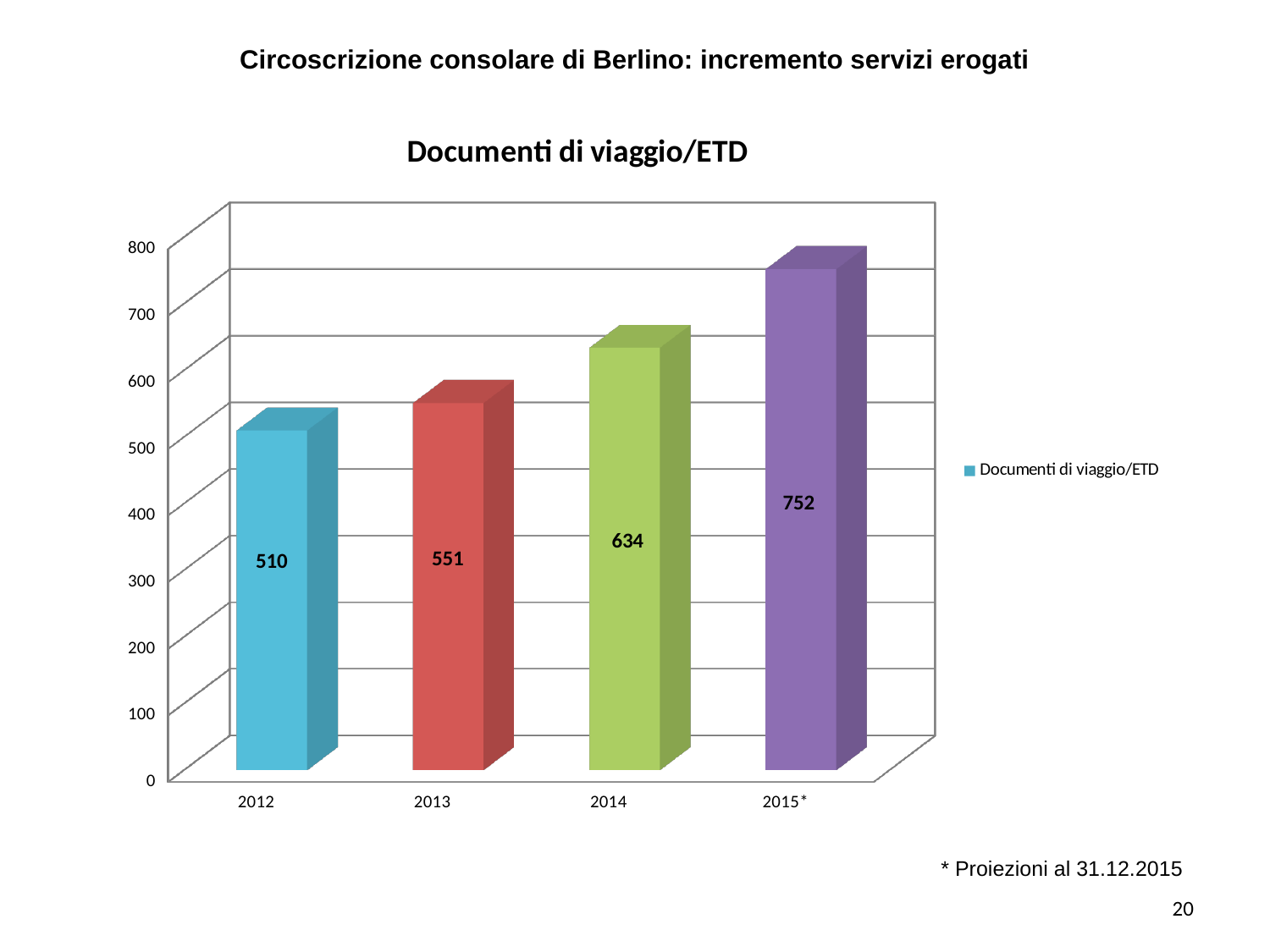
What kind of chart is shown on the slide? bar chart How many years are shown on the x axis of the chart? 4 What is the value for 2015* in the Documenti di viaggio/ETD chart? 752 What is the value for 2012 in the Documenti di viaggio/ETD chart? 510 What is the difference between the values for 2015* and 2014? 118 Which year has the highest value in the Documenti di viaggio/ETD chart? 2015* What is the difference between the values for 2013 and 2012? 41 Which is larger, the value for 2013 or the value for 2014? 2014 What is the value for 2014 in the Documenti di viaggio/ETD chart? 634 Which year has the lowest value in the Documenti di viaggio/ETD chart? 2012 Do the values rise or fall from 2012 to 2015*? rise Is the value for 2015* greater or less than 700? greater